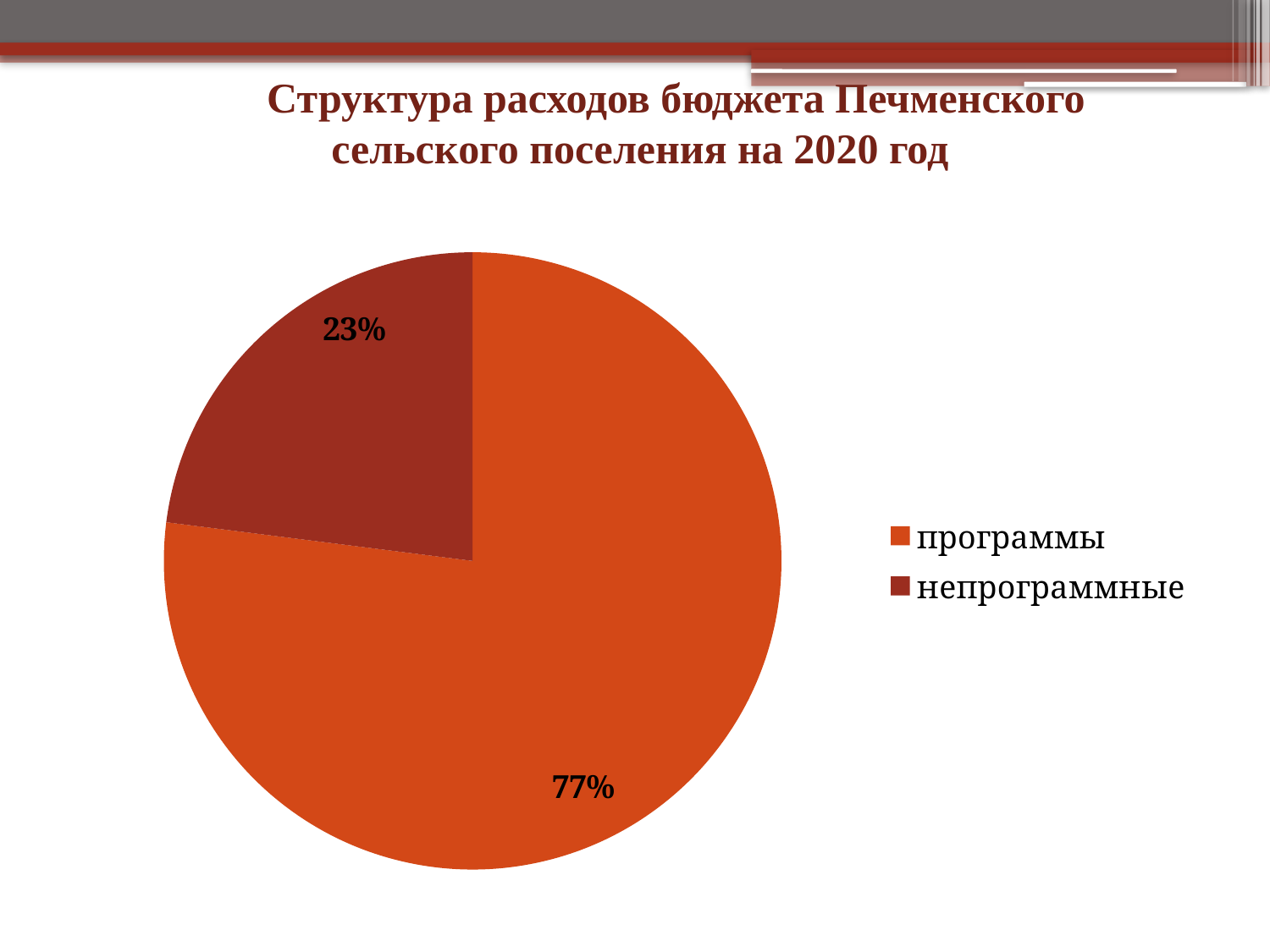
How many categories does the pie chart show? 2 What kind of chart is shown on the slide? pie chart What share of the pie does the 'непрограммные' slice take? 23% Which legend entry is shown in the darker red colour? непрограммные What is the difference in percentage points between the 'программы' and 'непрограммные' slices? 54 Which category has the largest slice of the pie? программы What is the title of the slide containing the chart? Структура расходов бюджета Печменского сельского поселения на 2020 год What share of the pie does the 'программы' slice take? 77% Which is larger, the 'программы' slice or the 'непрограммные' slice? программы Which category has the smallest slice of the pie? непрограммные How many entries does the legend list? 2